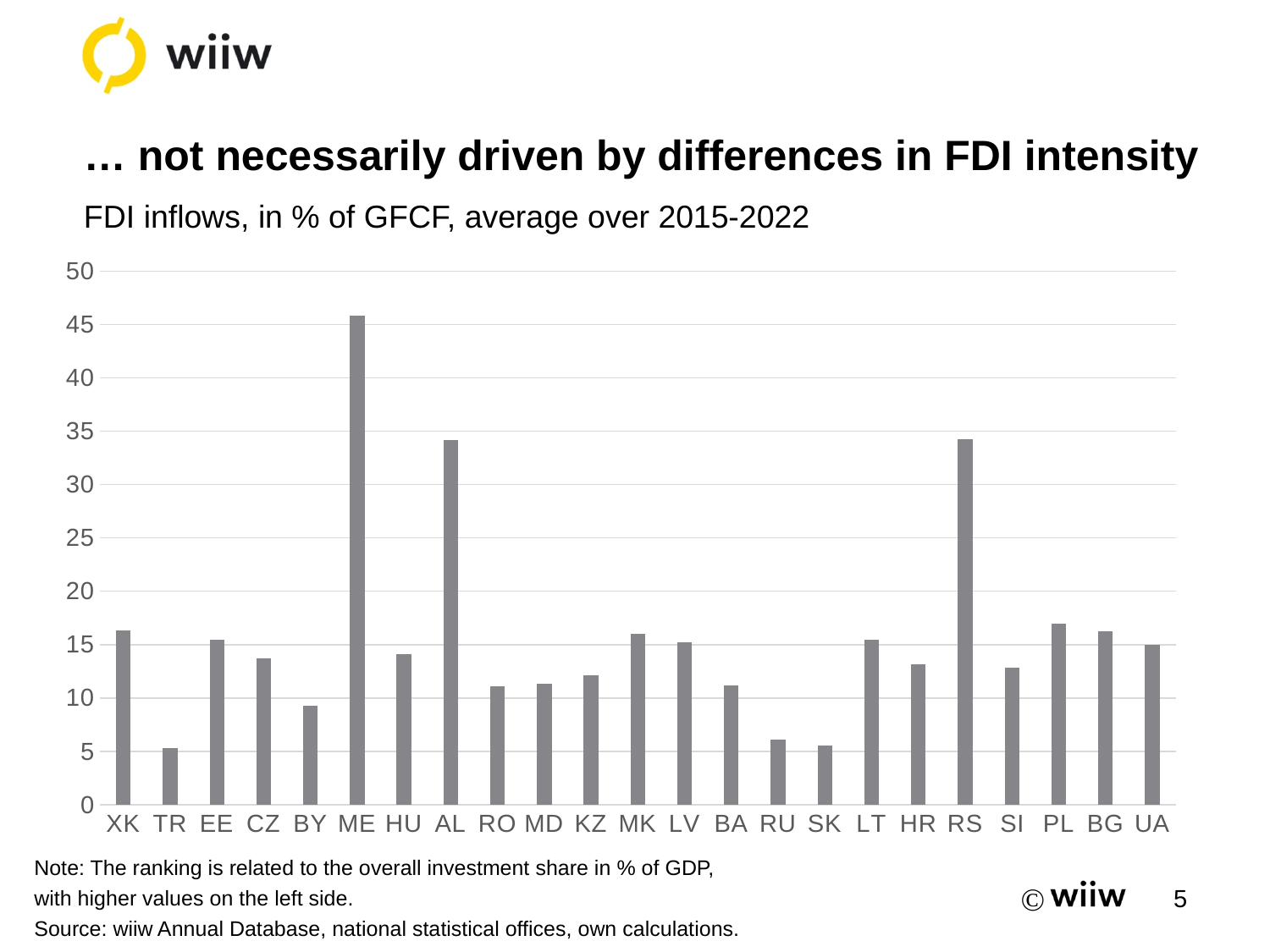
Which has a larger value, ME or AL? ME Is the value for HR greater or less than 15? less Which has a larger value, XK or BY? XK Is the value for ME greater or less than 40? greater Is the value for BY greater or less than 10? less Which country has the highest FDI inflows in % of GFCF? ME What kind of chart is shown on the slide? bar chart What is the subtitle describing the chart's data? FDI inflows, in % of GFCF, average over 2015-2022 How many countries are shown on the x axis? 23